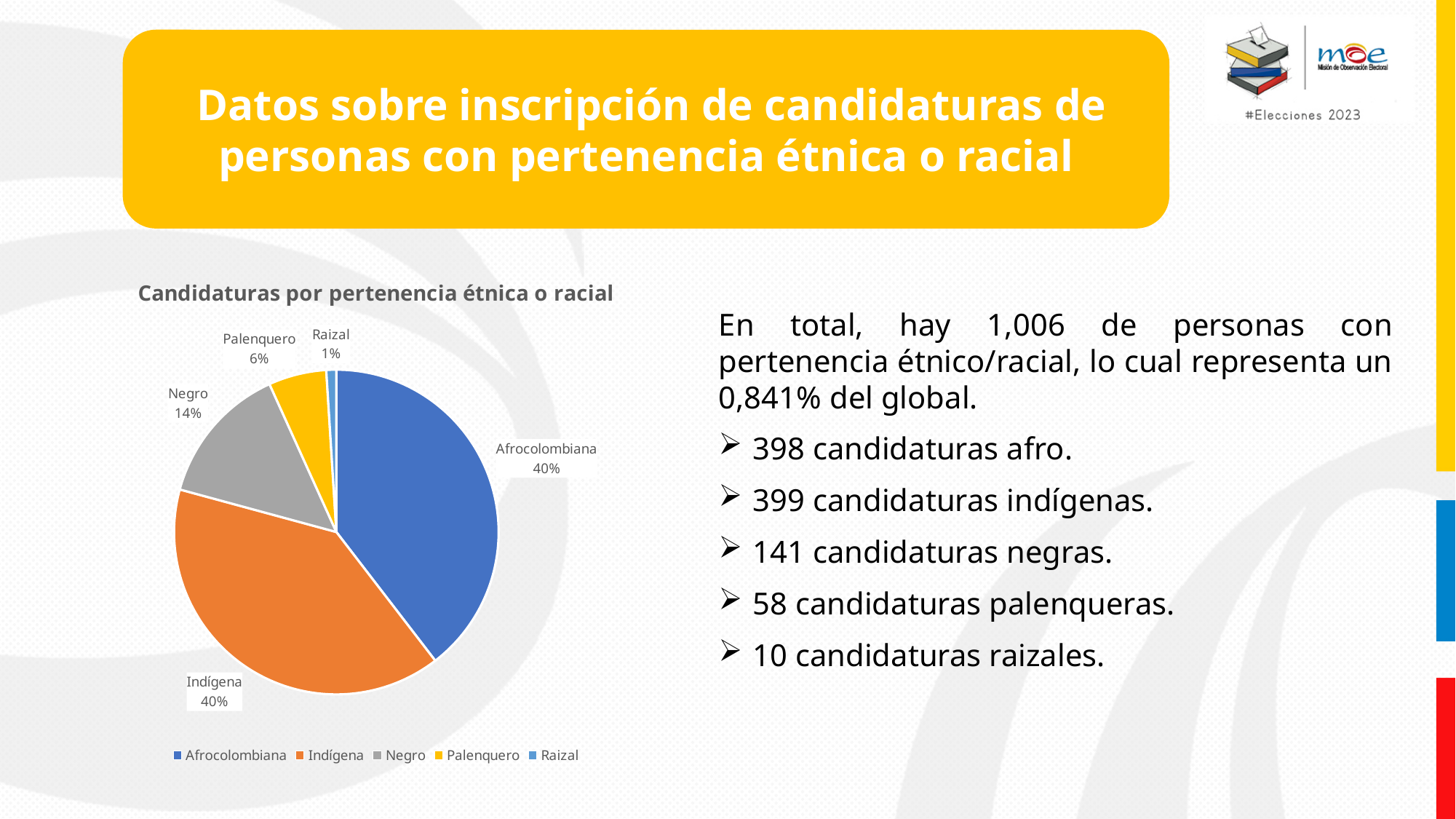
What percentage is shown for Indígena? 40% What type of chart is shown on the slide? Pie chart What is the difference in percentage points between the Negro slice and the Palenquero slice? 8 What percentage is shown for Raizal? 1% What percentage is shown for Palenquero? 6% What share of the pie does the Negro slice represent? 14% Which category is shown in orange in the pie chart? Indígena Which is larger, the Negro slice or the Palenquero slice? Negro What percentage is shown for Afrocolombiana? 40% How many categories are shown in the pie chart? 5 What is the title of the chart on the slide? Candidaturas por pertenencia étnica o racial Which category has the smallest slice of the pie? Raizal